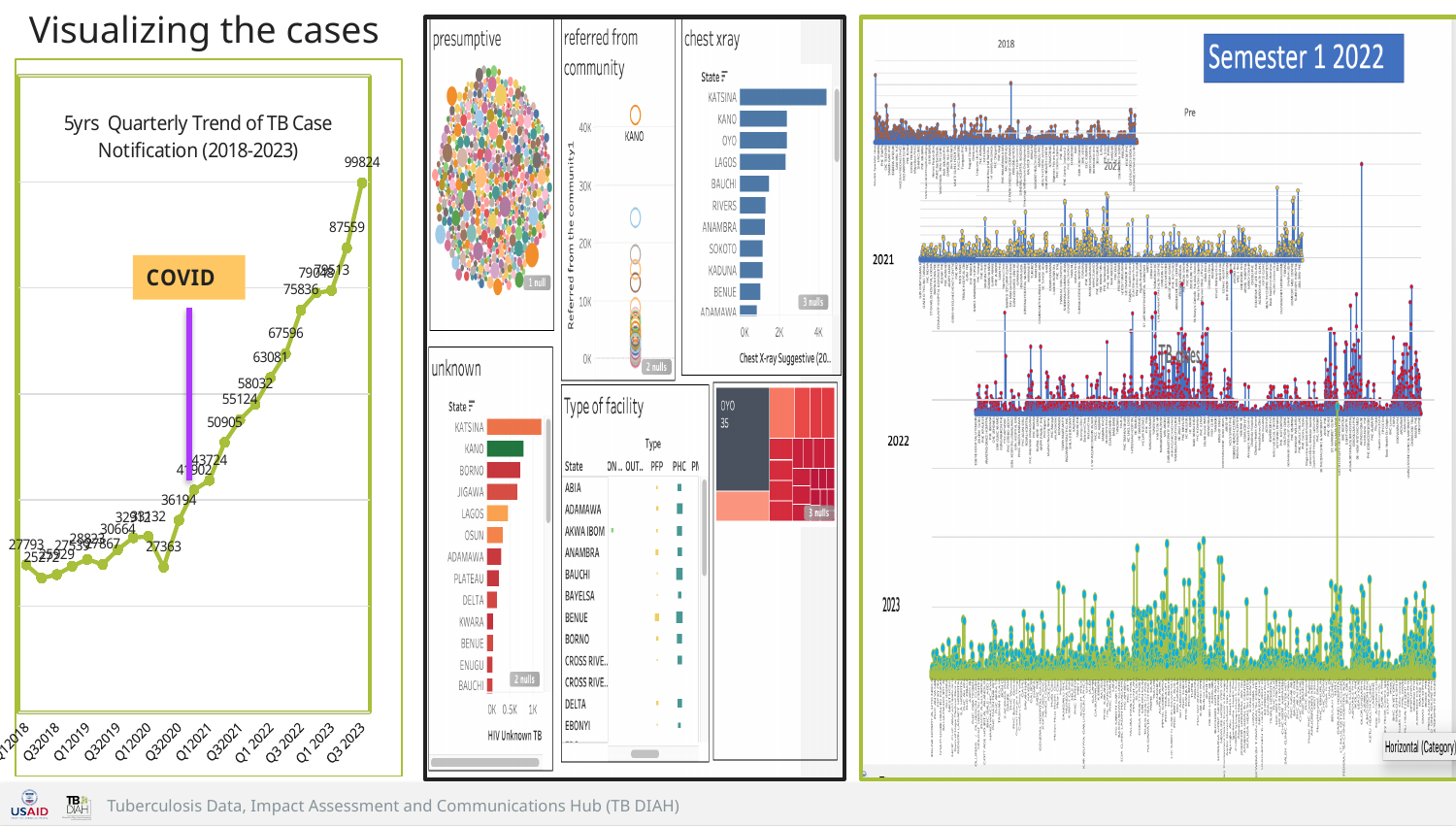
In the '5yrs Quarterly Trend of TB Case Notification (2018-2023)' chart, which is larger, the value 50905 or the value 43724? 50905 In the 'unknown' (HIV Unknown TB) bar chart in the middle panel, which has the longer bar, KANO or BORNO? KANO In the '5yrs Quarterly Trend of TB Case Notification (2018-2023)' chart, what is the value labelled at Q3 2023? 99824 What text is shown in the orange annotation box on the '5yrs Quarterly Trend of TB Case Notification (2018-2023)' chart? COVID In the '5yrs Quarterly Trend of TB Case Notification (2018-2023)' chart, what is the highest value shown? 99824 In the 'chest xray' bar chart in the middle panel, which state has the longest bar? KATSINA In the '5yrs Quarterly Trend of TB Case Notification (2018-2023)' chart, what is the difference between the last two labelled values, 99824 and 87559? 12265 What kind of chart is the '5yrs Quarterly Trend of TB Case Notification (2018-2023)' chart on the left? Line chart In the '5yrs Quarterly Trend of TB Case Notification (2018-2023)' chart, do the values generally rise or fall from 2018 to 2023? Rise In the 'unknown' (HIV Unknown TB) bar chart in the middle panel, which state has the longest bar? KATSINA What kind of chart is the 'chest xray' chart in the middle panel? Bar chart In the '5yrs Quarterly Trend of TB Case Notification (2018-2023)' chart, what is the difference between the values 75836 and 67596? 8240